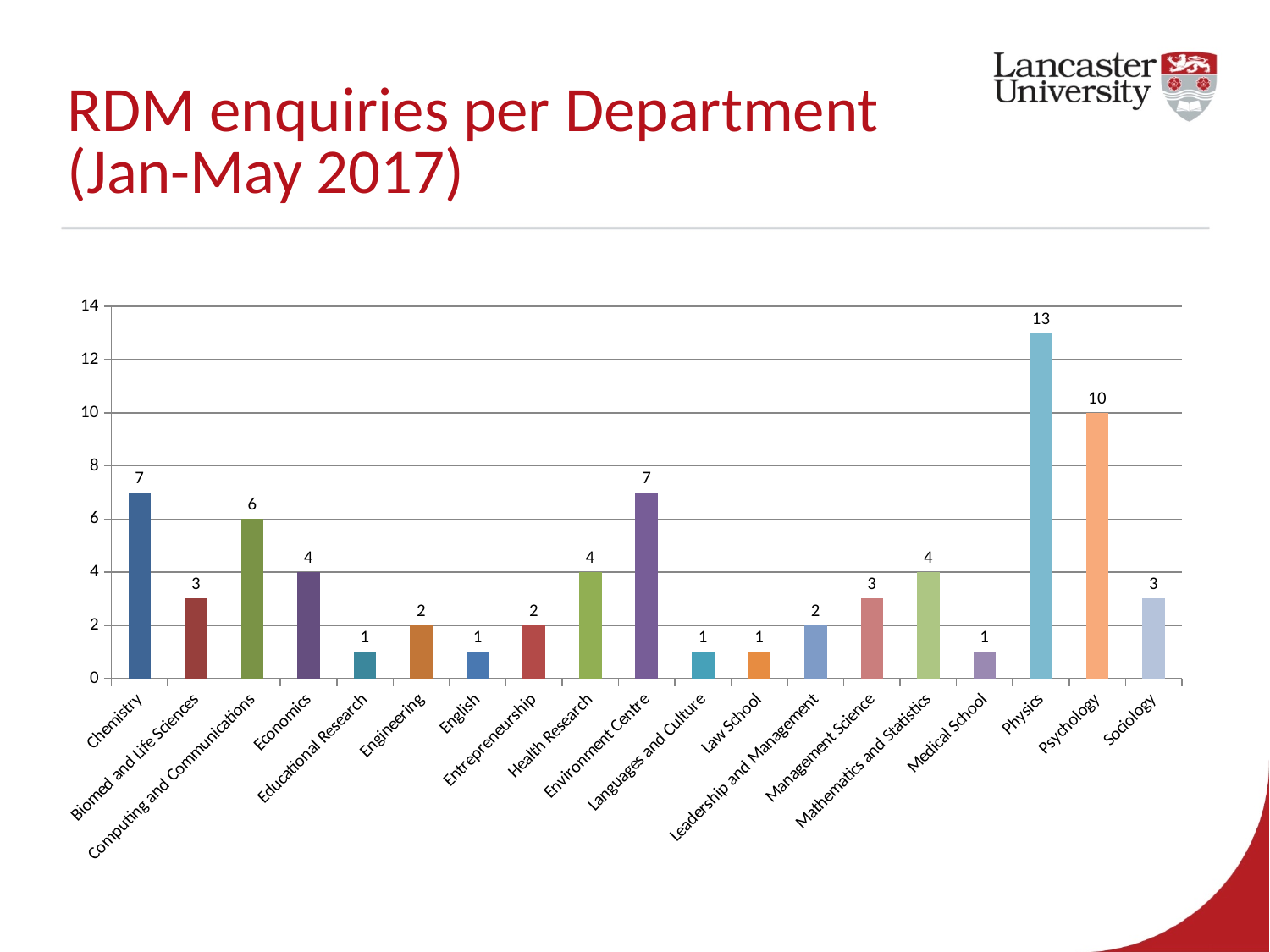
What is the difference between the values for Chemistry and Biomed and Life Sciences? 4 What is the difference between the values for Physics and Psychology? 3 What is the value for Computing and Communications? 6 What is the value for Environment Centre? 7 What kind of chart is shown on the slide? Bar chart Which has more enquiries, Health Research or Engineering? Health Research What is the title of the slide containing the chart? RDM enquiries per Department (Jan-May 2017) How many RDM enquiries did Physics have? 13 How many enquiries are shown for Psychology? 10 How many departments are shown on the x axis? 19 Which department has the highest number of RDM enquiries? Physics Which has more enquiries, Economics or Management Science? Economics